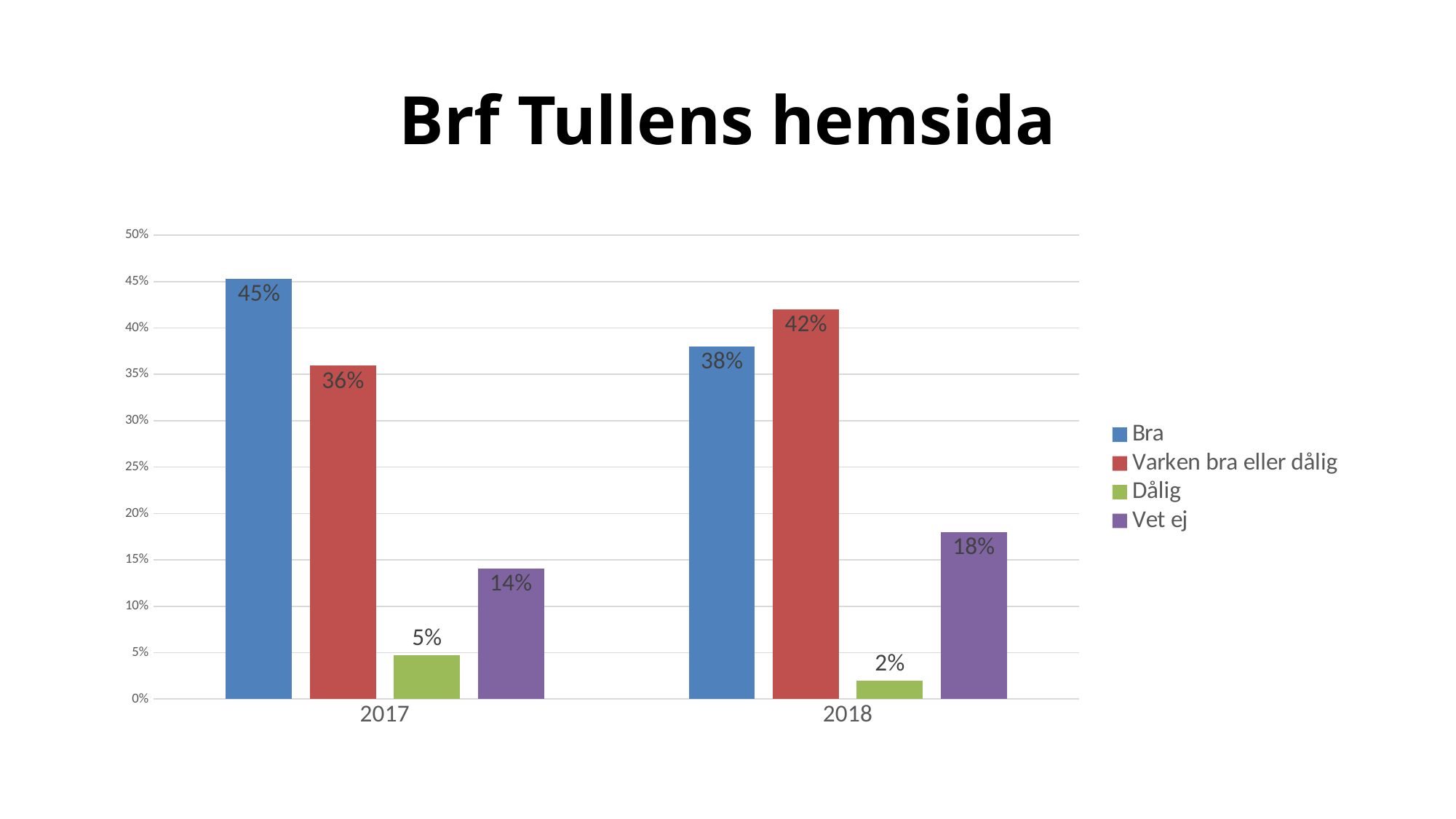
What is the difference between the Bra values for 2017 and 2018? 7% How many categories are shown on the x axis? 2 What is the value for Vet ej in 2017? 14% Which series has the lowest value in 2017? Dålig Which is larger: Vet ej in 2017 or Vet ej in 2018? Vet ej in 2018 What is the value for Varken bra eller dålig in 2018? 42% What is the value for Bra in 2017? 45% What is the title of the chart? Brf Tullens hemsida What is the value for Dålig in 2018? 2% How many series does the legend list? 4 Which series has the highest value in 2018? Varken bra eller dålig What kind of chart is shown on the slide? Bar chart